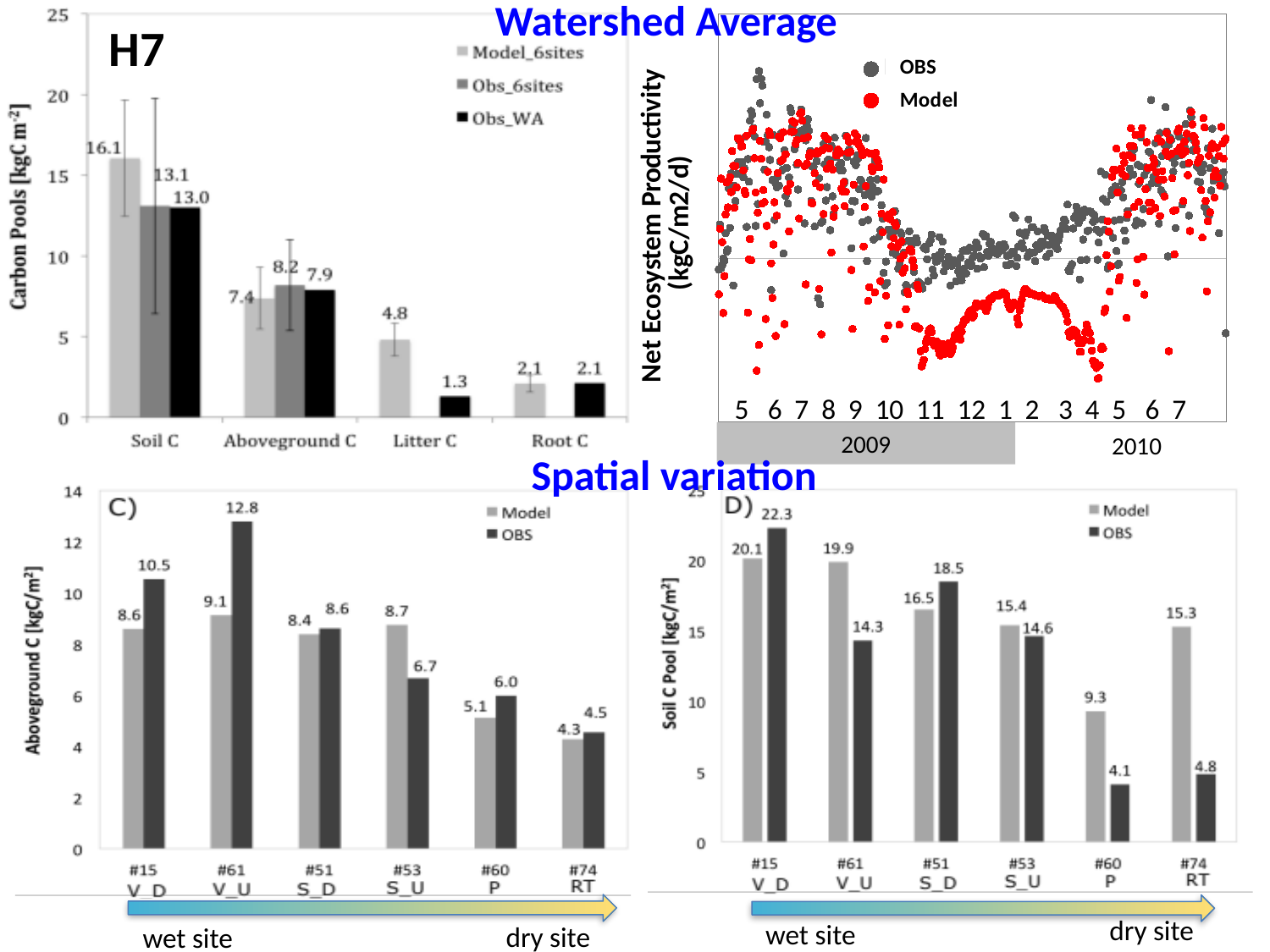
In the bottom-left chart C), which site has the lowest Model value? #74 RT In the bottom-right chart D), what is the difference between the Model and OBS values for #74 RT? 10.5 In the top-left H7 chart, what is the difference between the Model_6sites and Obs_6sites values for Soil C? 3.0 In the bottom-right chart D), what is the OBS value for #60 P? 4.1 What kind of chart is the top-right Watershed Average chart? Scatter chart In the bottom-right chart D), which site has the highest OBS value? #15 V_D In the bottom-left chart C), what is the OBS value for #61 V_U? 12.8 In the top-left H7 chart, what is the Model_6sites value for Soil C? 16.1 In the bottom-left chart C), is the Model value or the OBS value larger for #53 S_U? Model In the top-left H7 chart, what is the Obs_WA value for Litter C? 1.3 Which two series does the legend of the top-right Watershed Average chart list? OBS and Model How many series does the legend of the top-left H7 chart list? 3